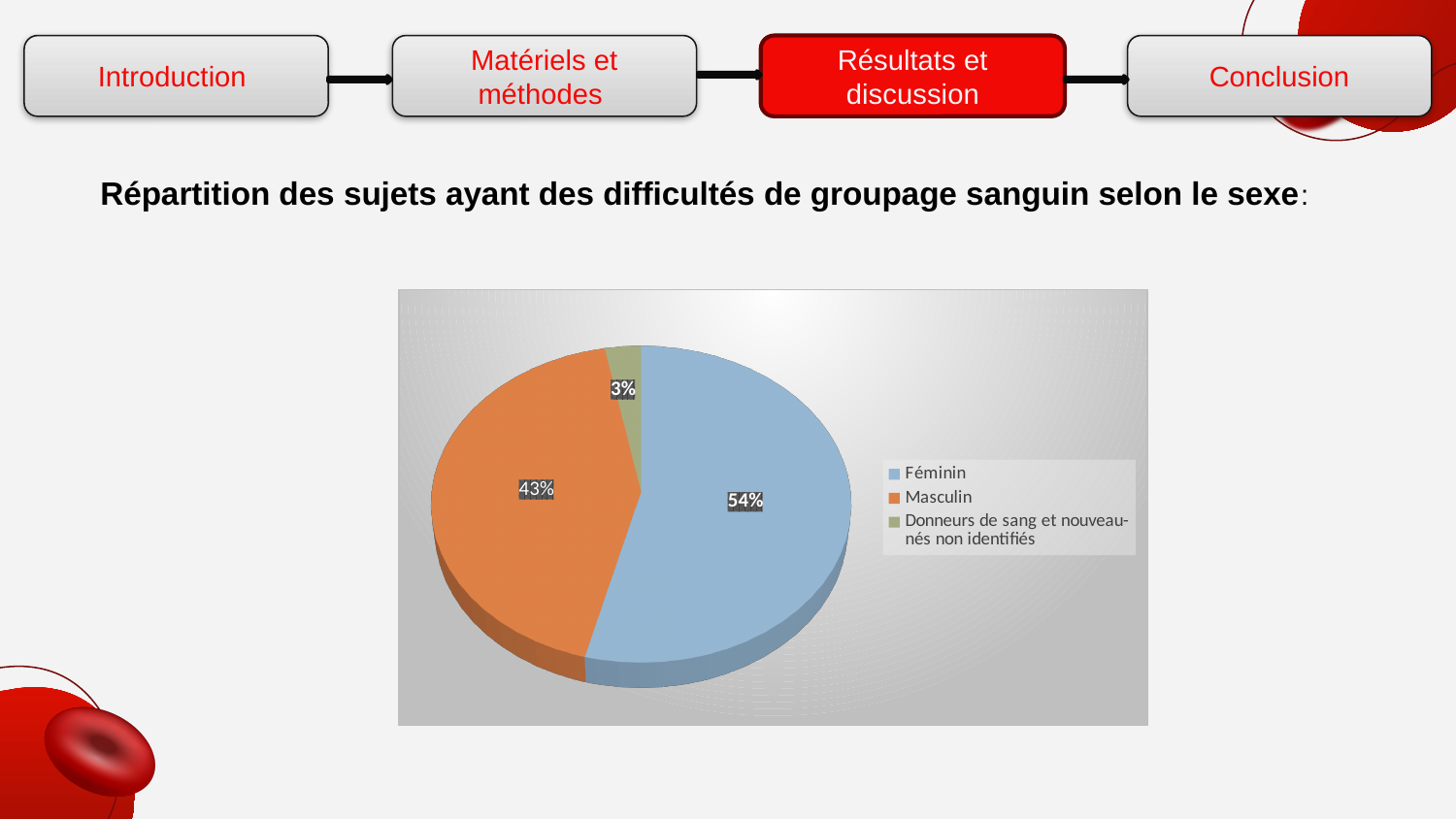
What is the difference in percentage points between the Féminin and Masculin slices? 11 Which slice is larger, Féminin or Masculin? Féminin What colour is the Masculin slice? orange Which category has the largest slice of the pie? Féminin How many slices does the pie chart have? 3 What share of the pie does Féminin represent? 54% What kind of chart is shown on the slide? pie chart How many entries does the legend list? 3 What share of the pie does Masculin represent? 43% What is the title shown above the chart? Répartition des sujets ayant des difficultés de groupage sanguin selon le sexe Which category has the smallest slice of the pie? Donneurs de sang et nouveau-nés non identifiés What share of the pie does 'Donneurs de sang et nouveau-nés non identifiés' represent? 3%